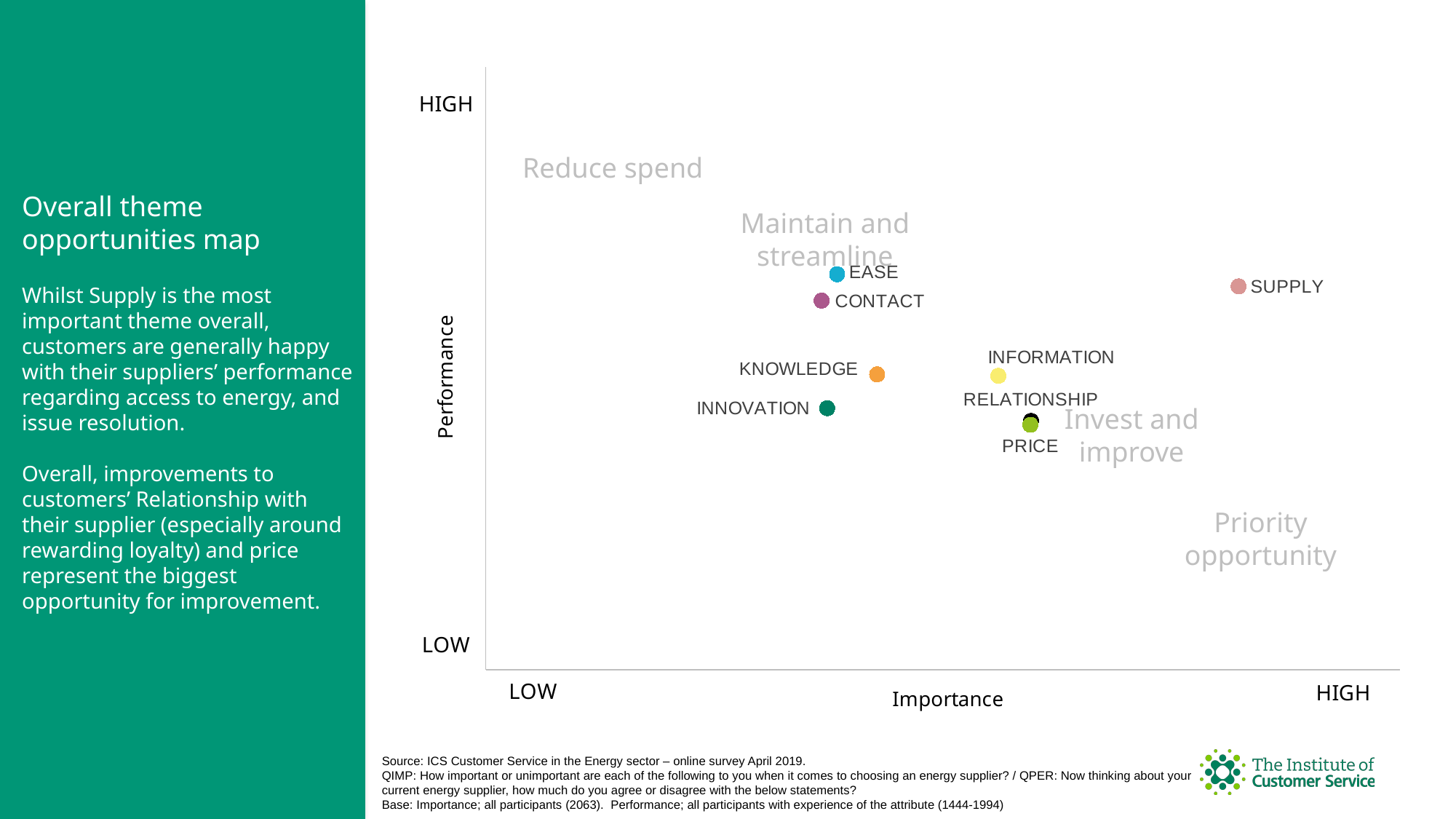
Which has higher performance, EASE or INNOVATION? EASE How many themes are plotted on the opportunities map? 8 What kind of chart is shown on the slide? Scatter chart Which has higher performance, CONTACT or KNOWLEDGE? CONTACT Which has higher importance, INFORMATION or KNOWLEDGE? INFORMATION Which theme has the highest importance? SUPPLY What is the label of the vertical axis? Performance